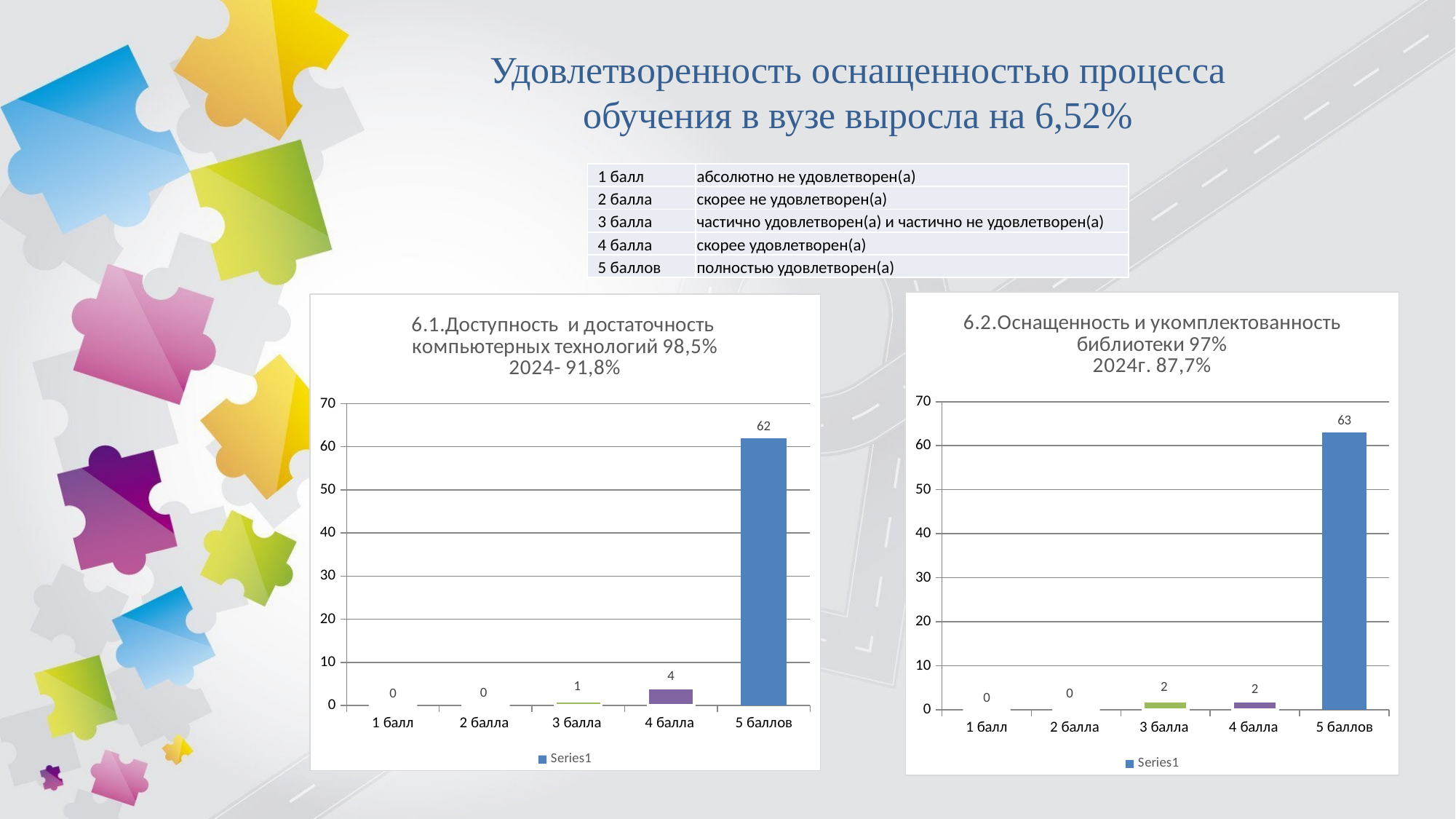
In the left chart (6.1. Доступность и достаточность компьютерных технологий), what is the value for 5 баллов? 62 In the right chart (6.2. Оснащенность и укомплектованность библиотеки), what is the value for 3 балла? 2 In the right chart (6.2. Оснащенность и укомплектованность библиотеки), what is the value for 5 баллов? 63 In the left chart (6.1. Доступность и достаточность компьютерных технологий), which category has the highest value? 5 баллов In the left chart (6.1. Доступность и достаточность компьютерных технологий), what is the difference between the values for 5 баллов and 4 балла? 58 In the right chart (6.2. Оснащенность и укомплектованность библиотеки), what is the difference between the values for 5 баллов and 3 балла? 61 How many categories are shown on the x axis of the left chart (6.1. Доступность и достаточность компьютерных технологий)? 5 Which is larger: the value for 5 баллов in the left chart (6.1) or the value for 5 баллов in the right chart (6.2)? Right chart (6.2), 63 What kind of chart is the right chart (6.2. Оснащенность и укомплектованность библиотеки)? Bar chart How many series does the legend of the left chart (6.1. Доступность и достаточность компьютерных технологий) list? 1 In the left chart (6.1. Доступность и достаточность компьютерных технологий), what is the value for 4 балла? 4 In the right chart (6.2. Оснащенность и укомплектованность библиотеки), which category has the highest value? 5 баллов